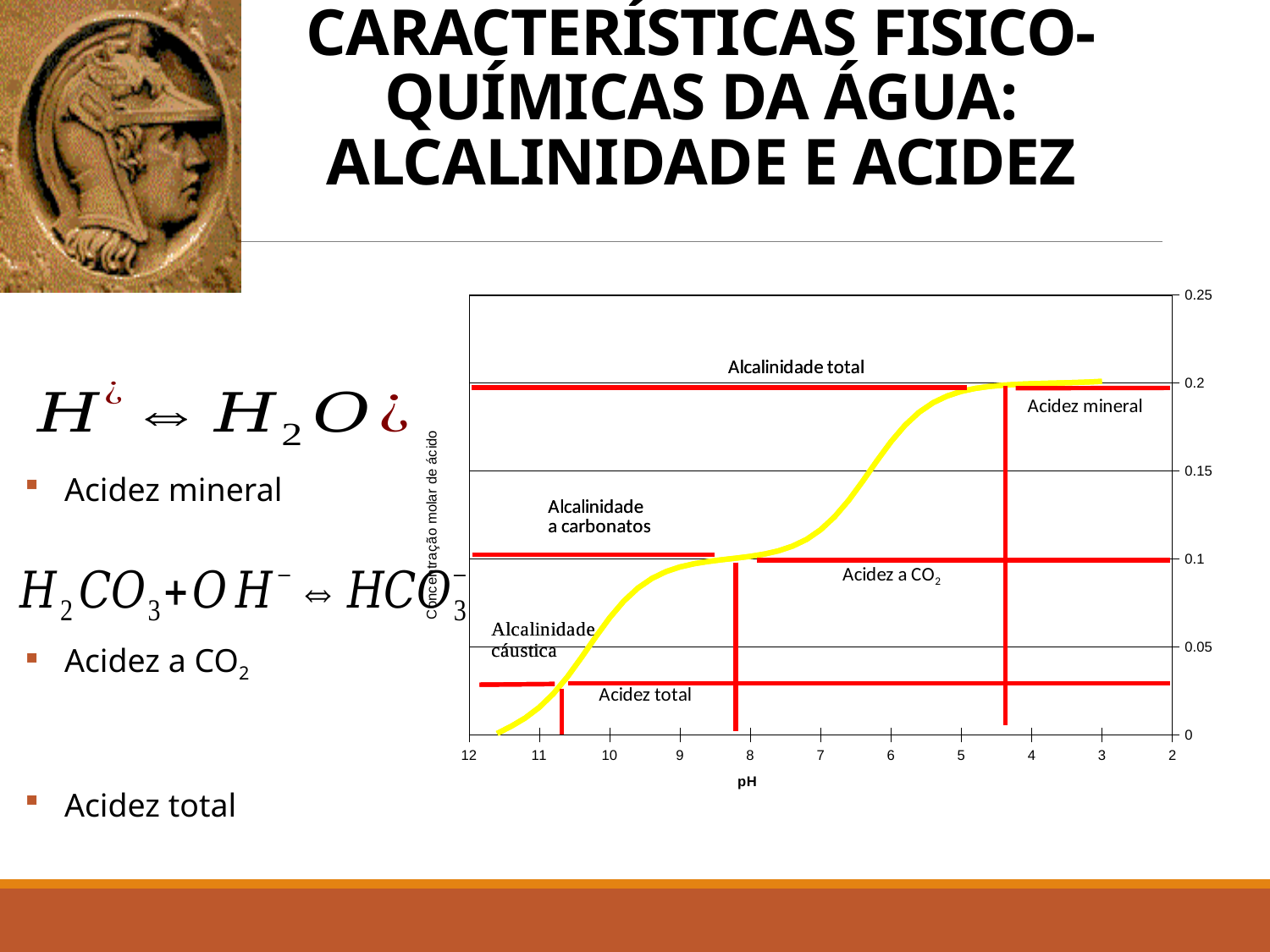
Do the values of the curve rise or fall from left to right along the pH axis? rise Is the acid concentration higher at pH 11 or at pH 3? pH 3 Is the acid concentration at pH 9 greater or less than 0.05? greater What is the label of the x axis of the chart? pH What kind of chart is shown on the slide? line chart What is the label of the y axis of the chart? Concentração molar de ácido Is the acid concentration at pH 3 greater or less than 0.15? greater Is the acid concentration at pH 11 greater or less than 0.05? less What is the highest value shown on the y axis of the chart? 0.25 Is the acid concentration higher at pH 10 or at pH 6? pH 6